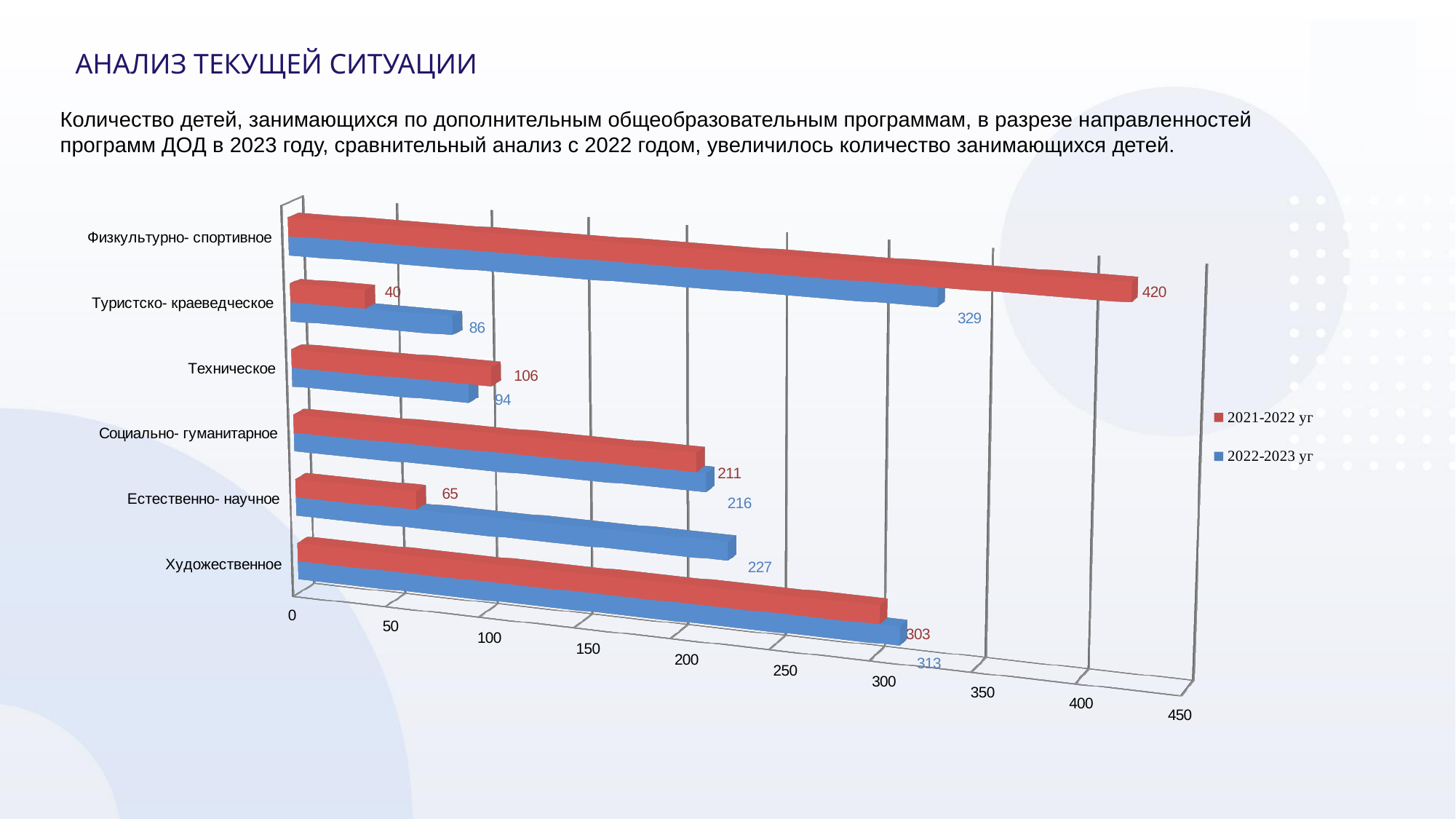
How many series does the legend list? 2 Which category has the lowest value in the 2022-2023 уг series? Туристско- краеведческое For Техническое, which series has the larger value: 2021-2022 уг or 2022-2023 уг? 2021-2022 уг What kind of chart is shown on the slide? bar chart Which colour represents the 2022-2023 уг series? blue How many categories are shown on the chart? 6 What is the value for Физкультурно- спортивное in the 2022-2023 уг series? 329 What is the difference between the 2021-2022 уг and 2022-2023 уг values for Естественно- научное? 162 Which category has the highest value in the 2021-2022 уг series? Физкультурно- спортивное What is the value for Естественно- научное in the 2022-2023 уг series? 227 What is the value for Физкультурно- спортивное in the 2021-2022 уг series? 420 What is the value for Туристско- краеведческое in the 2021-2022 уг series? 40